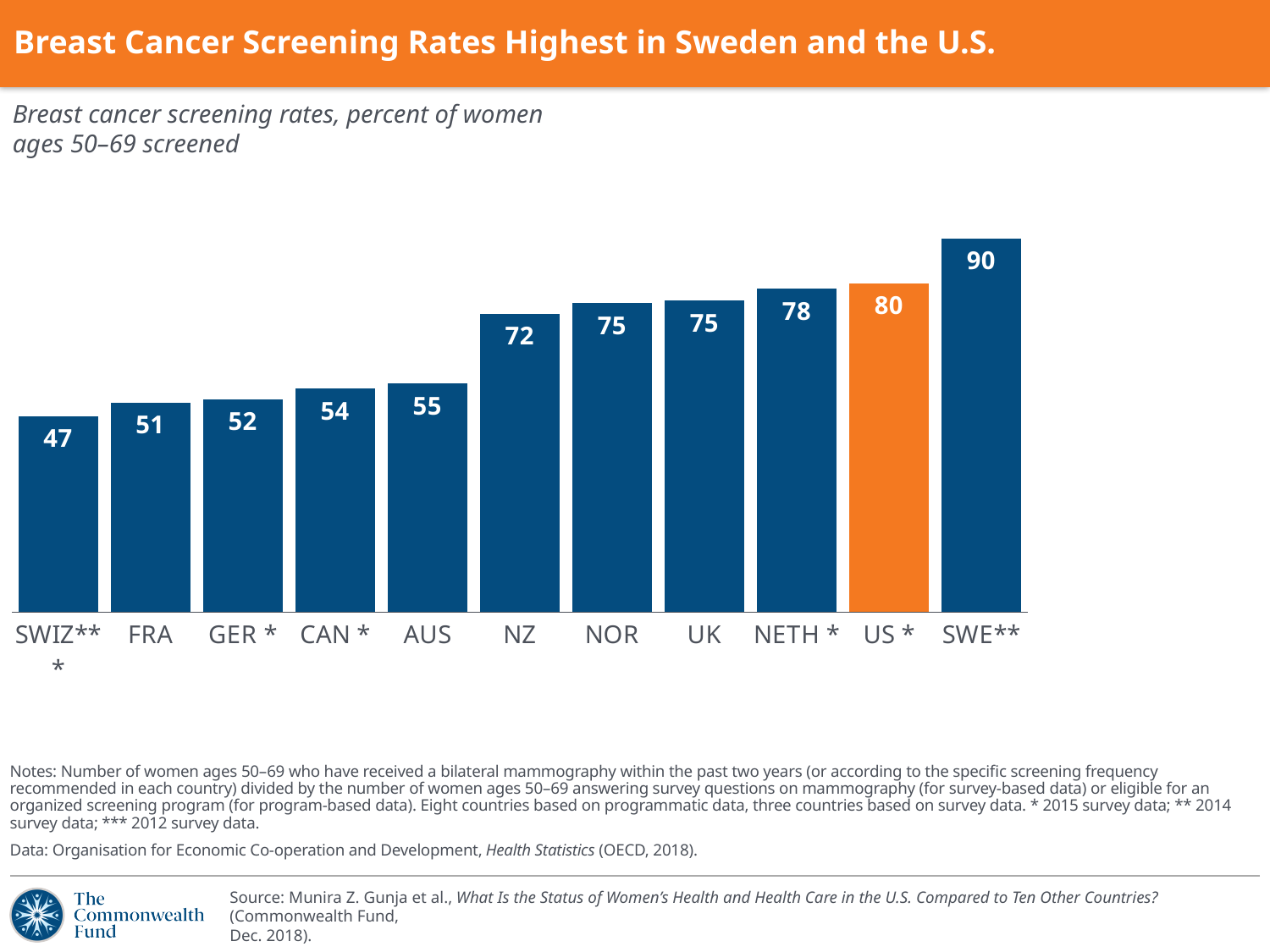
How many countries are shown in the chart? 11 What is the breast cancer screening rate for NZ? 72 Which country has the highest breast cancer screening rate? SWE** What is the difference between the screening rates of SWE** and US *? 10 Do the screening rates rise or fall from left to right across the chart? Rise What type of chart is shown on the slide? Bar chart Which country's bar is shown in orange rather than blue? US * What is the breast cancer screening rate for US *? 80 Which has a higher screening rate, AUS or CAN *? AUS Which country has the lowest breast cancer screening rate? SWIZ*** What is the difference between the screening rates of NETH * and SWIZ***? 31 What is the breast cancer screening rate for SWE**? 90